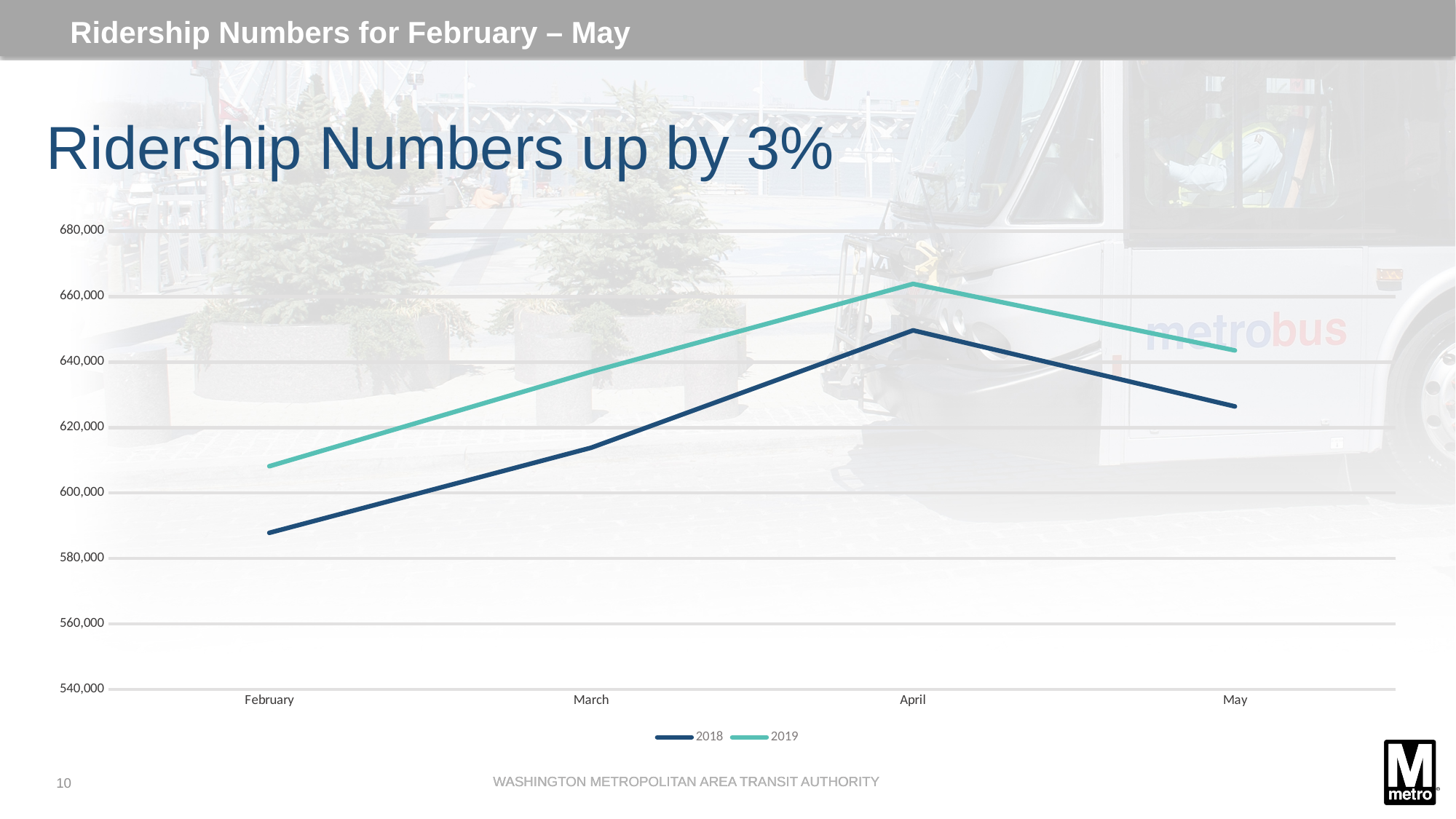
What are the two entries in the chart legend? 2018 and 2019 What kind of chart is shown on the slide? line chart Does the 2019 series rise or fall from February to April? rise How many months are plotted along the x axis? 4 Which series is higher in March, 2018 or 2019? 2019 Does the 2018 series rise or fall from April to May? fall Is the 2018 value for May greater or less than 640,000? less In which month is the 2018 series at its lowest value? February Is the 2018 value for February greater or less than 600,000? less In which month does the 2019 series reach its highest value? April How many series does the legend list? 2 Is the 2019 value for April greater or less than 660,000? greater